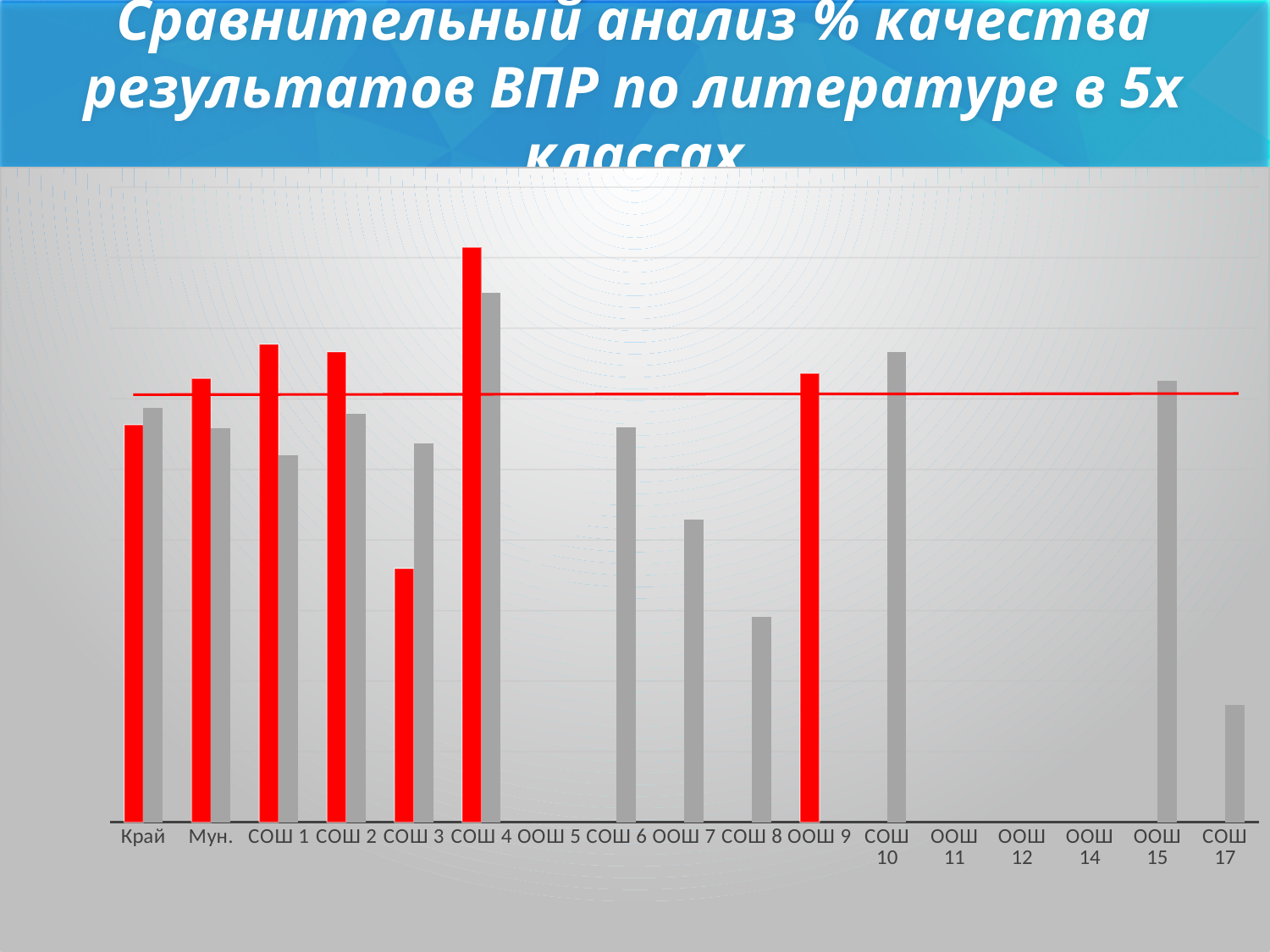
How many red bars are plotted in the chart? 7 Which red bar is taller, СОШ 3 or ООШ 9? ООШ 9 Which category has the tallest grey bar in the chart? СОШ 4 How many categories in the chart have no bars at all? 4 How many categories are listed along the x axis of the chart? 17 What kind of chart is shown on the slide? Bar chart What two colours are used for the bars in the chart? Red and grey Which grey bar is taller, СОШ 10 or ООШ 15? СОШ 10 Which grey bar is taller, ООШ 7 or СОШ 8? ООШ 7 Which category has the shortest red bar in the chart? СОШ 3 Which category has the shortest grey bar in the chart? СОШ 17 Which category has the tallest red bar in the chart? СОШ 4